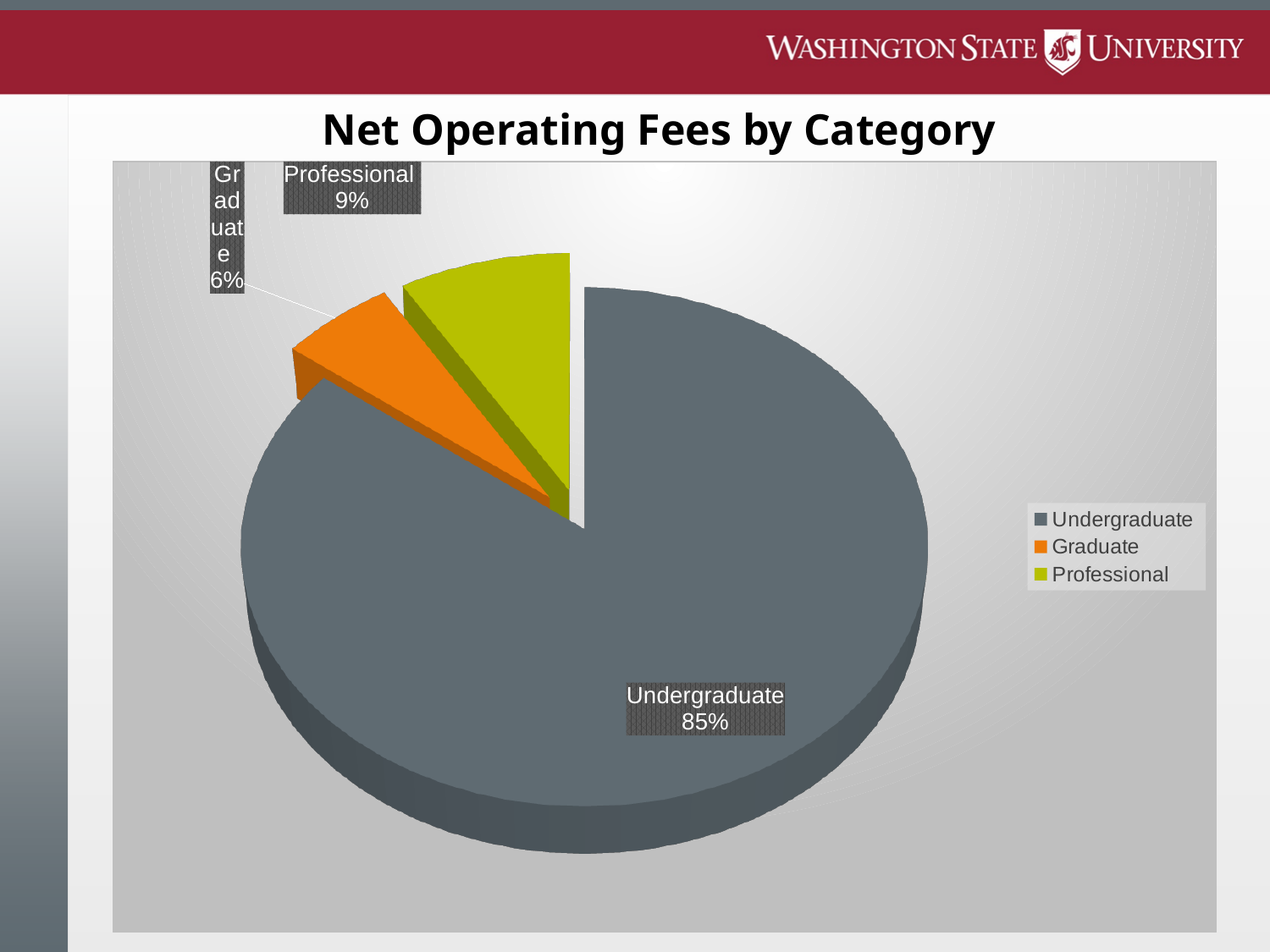
What is the difference in percentage points between the Undergraduate share and the Professional share? 76 What is the title of the chart? Net Operating Fees by Category How many entries does the legend list? 3 What type of chart is shown on the slide? Pie chart How many categories are shown in the pie chart? 3 What share of net operating fees does the Graduate slice represent? 6% What share of net operating fees does the Professional slice represent? 9% Which category has the smallest share of net operating fees? Graduate Which category has the largest share of net operating fees? Undergraduate Which is larger, the Professional share or the Graduate share? Professional What colour is the Graduate slice in the pie chart? Orange What share of net operating fees does the Undergraduate slice represent? 85%